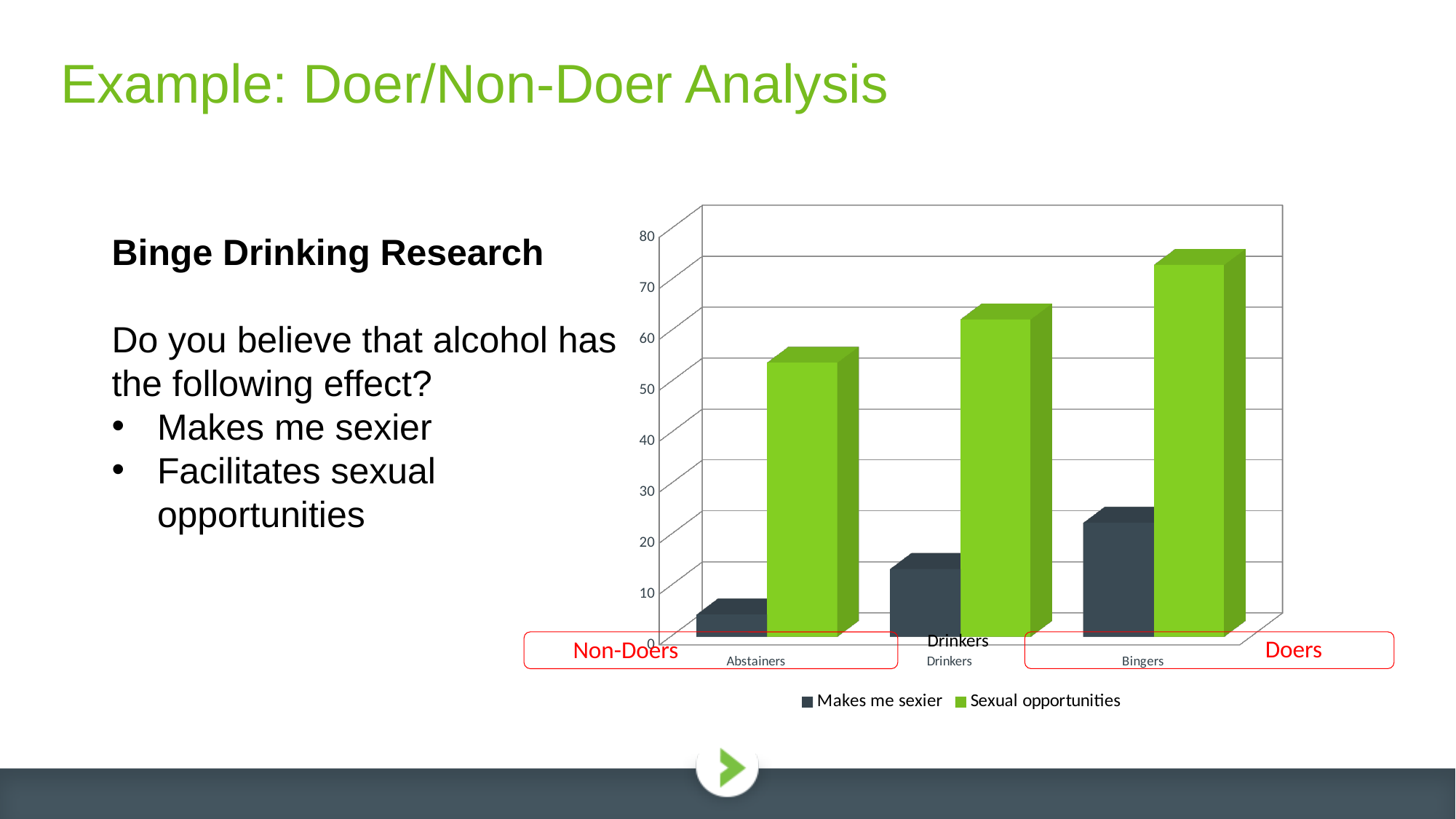
Which colour represents the Sexual opportunities series in the chart? Green Is the value for Makes me sexier for Drinkers greater or less than 20? less Which is larger for Drinkers: Makes me sexier or Sexual opportunities? Sexual opportunities Which category has the lowest value for Makes me sexier? Abstainers How many series does the chart's legend list? 2 How many categories are shown on the x axis of the chart? 3 Is the value for Sexual opportunities for Bingers greater or less than 70? greater Is the value for Makes me sexier for Abstainers greater or less than 10? less Do the values for Makes me sexier rise or fall from Abstainers to Bingers? rise What kind of chart is shown on the slide? Bar chart Which category has the highest value for Sexual opportunities? Bingers